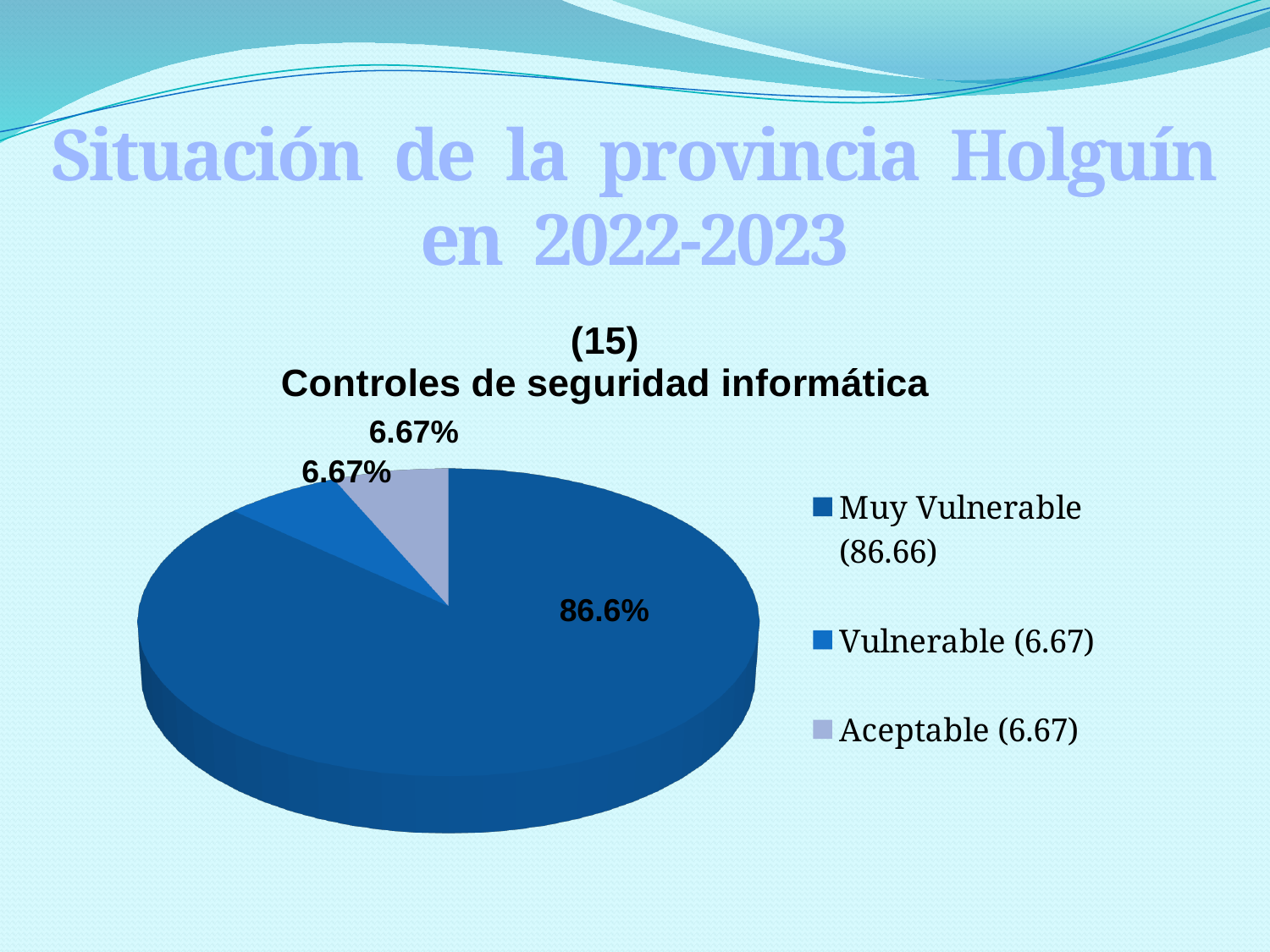
Which is larger, the Muy Vulnerable slice or the Aceptable slice? Muy Vulnerable Do the Vulnerable and Aceptable slices have the same percentage? Yes What percentage is shown for the Aceptable slice? 6.67% How many slices does the pie chart have? 3 How many entries does the legend list? 3 Which category is shown in the light grey-blue colour? Aceptable What is the title of the chart? (15) Controles de seguridad informática What percentage is shown for the Vulnerable slice? 6.67% Which category has the largest slice of the pie? Muy Vulnerable What kind of chart is shown on the slide? Pie chart What share of the pie does the Vulnerable slice represent? 6.67% What percentage is shown for the Muy Vulnerable slice? 86.6%